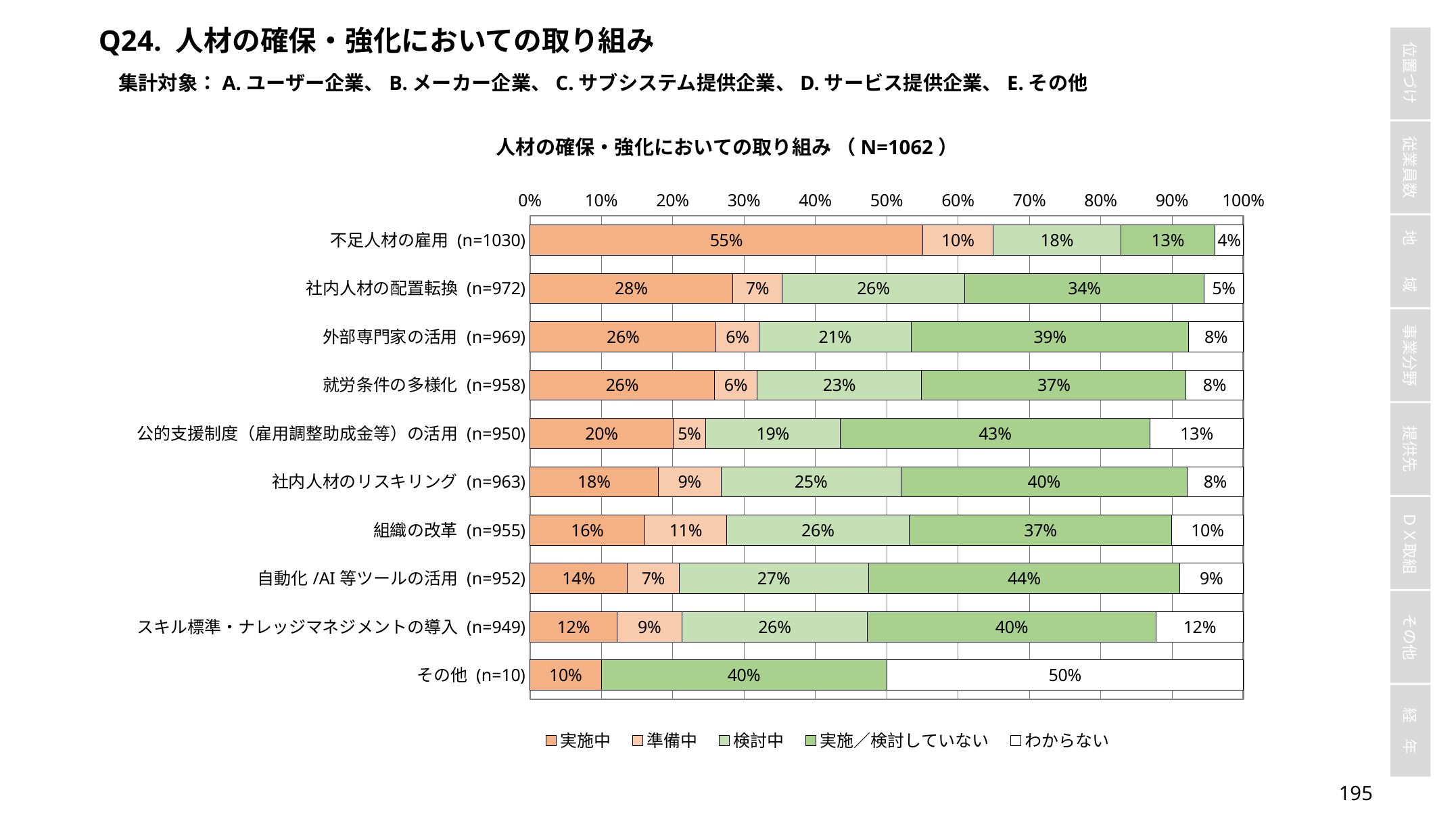
How many categories (bars) are shown in the chart? 10 Which has the larger 実施中 value: 外部専門家の活用 or 社内人材のリスキリング? 外部専門家の活用 What is the 実施／検討していない value for 自動化 /AI 等ツールの活用 (n=952)? 44% How many series does the legend list? 5 What kind of chart is shown on the slide? Stacked bar chart Which category has the highest わからない value? その他 (n=10) What is the 実施中 value for 不足人材の雇用 (n=1030)? 55% What is the difference between the 実施中 values for 不足人材の雇用 and 社内人材の配置転換? 27 percentage points What is the わからない value for 公的支援制度（雇用調整助成金等）の活用 (n=950)? 13% Which category has the lowest 実施中 value? その他 (n=10) What is the 準備中 value for 組織の改革 (n=955)? 11% Which category has the highest 実施中 value? 不足人材の雇用 (n=1030)